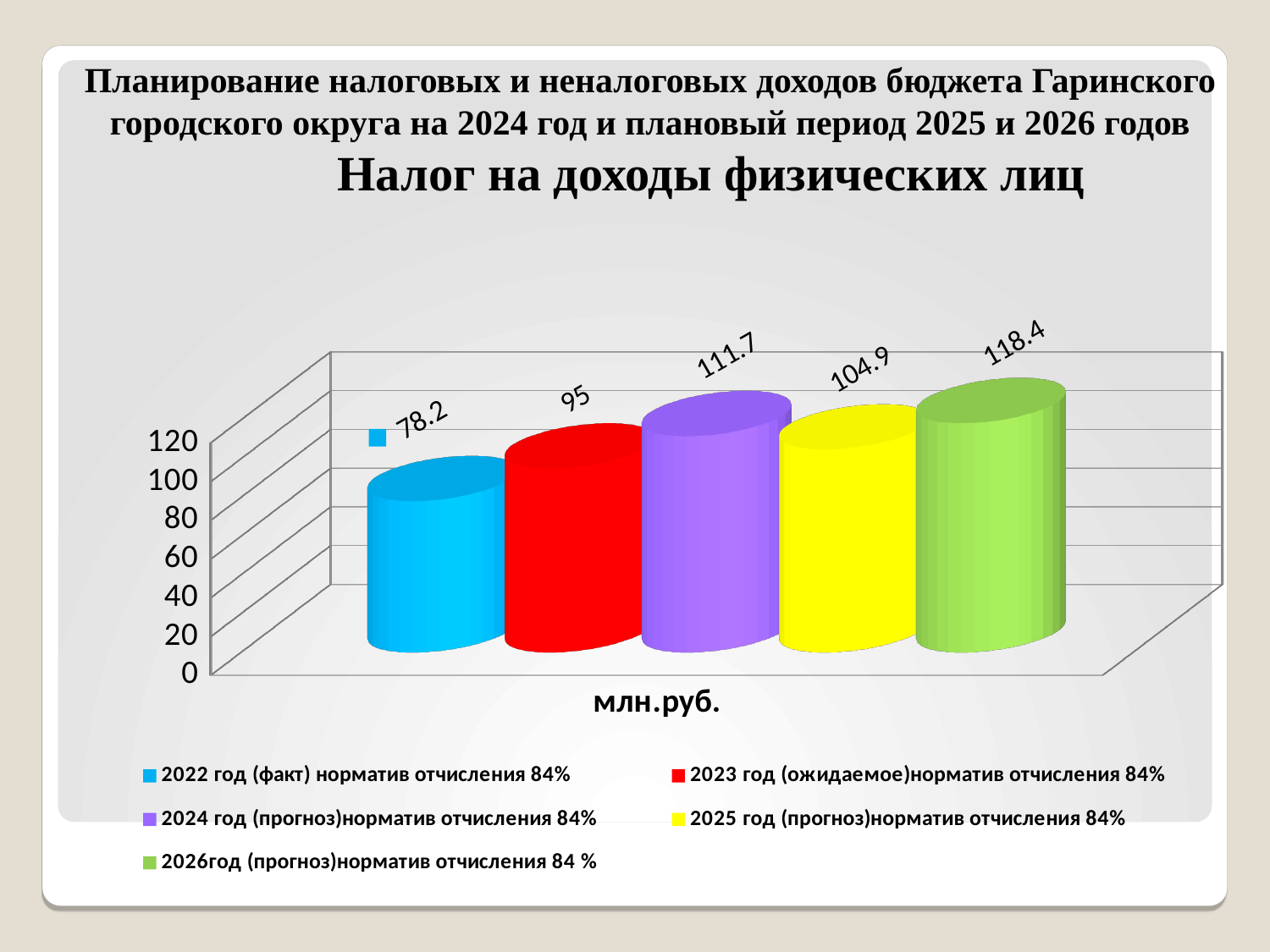
What unit is shown on the chart's horizontal axis label? млн.руб. How many series does the legend list? 5 What is the difference between the values for 2026 год and 2022 год? 40.2 What is the value for 2022 год (факт)? 78.2 What is the value for 2024 год (прогноз)? 111.7 What is the value for 2026 год (прогноз)? 118.4 Which year has the lowest value? 2022 год (факт) Which year has the highest value? 2026 год (прогноз) What is the value for 2025 год (прогноз)? 104.9 What is the value for 2023 год (ожидаемое)? 95 What kind of chart is shown? Bar chart Which is larger, the value for 2024 год or 2025 год? 2024 год